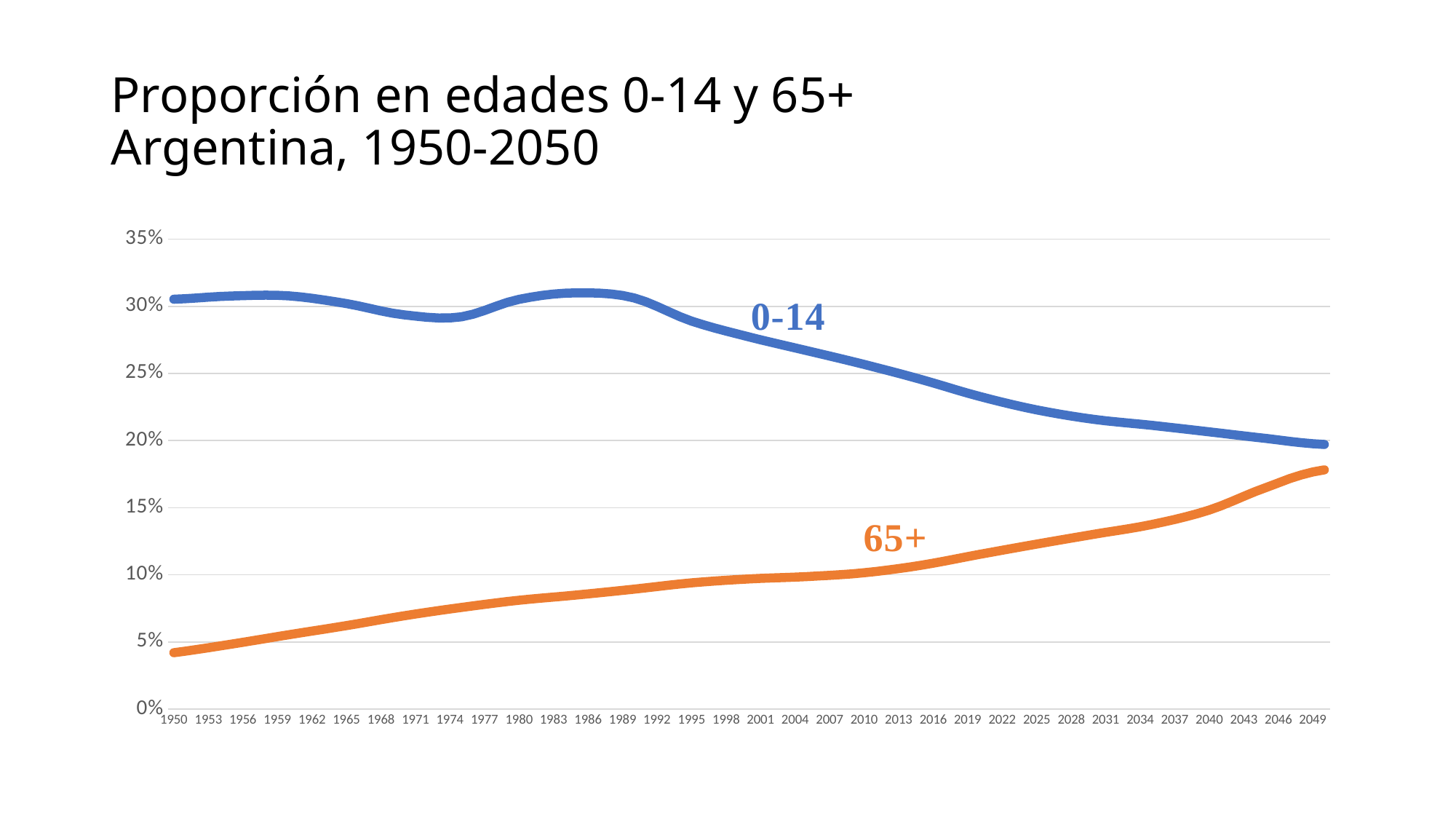
Is the value for 0-14 in 2049 greater or less than 25%? less Is the value for 65+ in 2049 greater or less than 15%? greater Is the value for 0-14 in 1950 greater or less than 25%? greater What is the title of the chart on the slide? Proporción en edades 0-14 y 65+ Argentina, 1950-2050 What kind of chart is shown on the slide? Line chart How many series are plotted on the chart? 2 Does the 65+ series rise or fall from 1950 to 2049? Rises Which series has the higher value in 2049, 0-14 or 65+? 0-14 Which series has the higher value in 1950, 0-14 or 65+? 0-14 Which colour is used for the 65+ series? Orange Does the 0-14 series rise or fall overall from 1989 to 2049? Falls